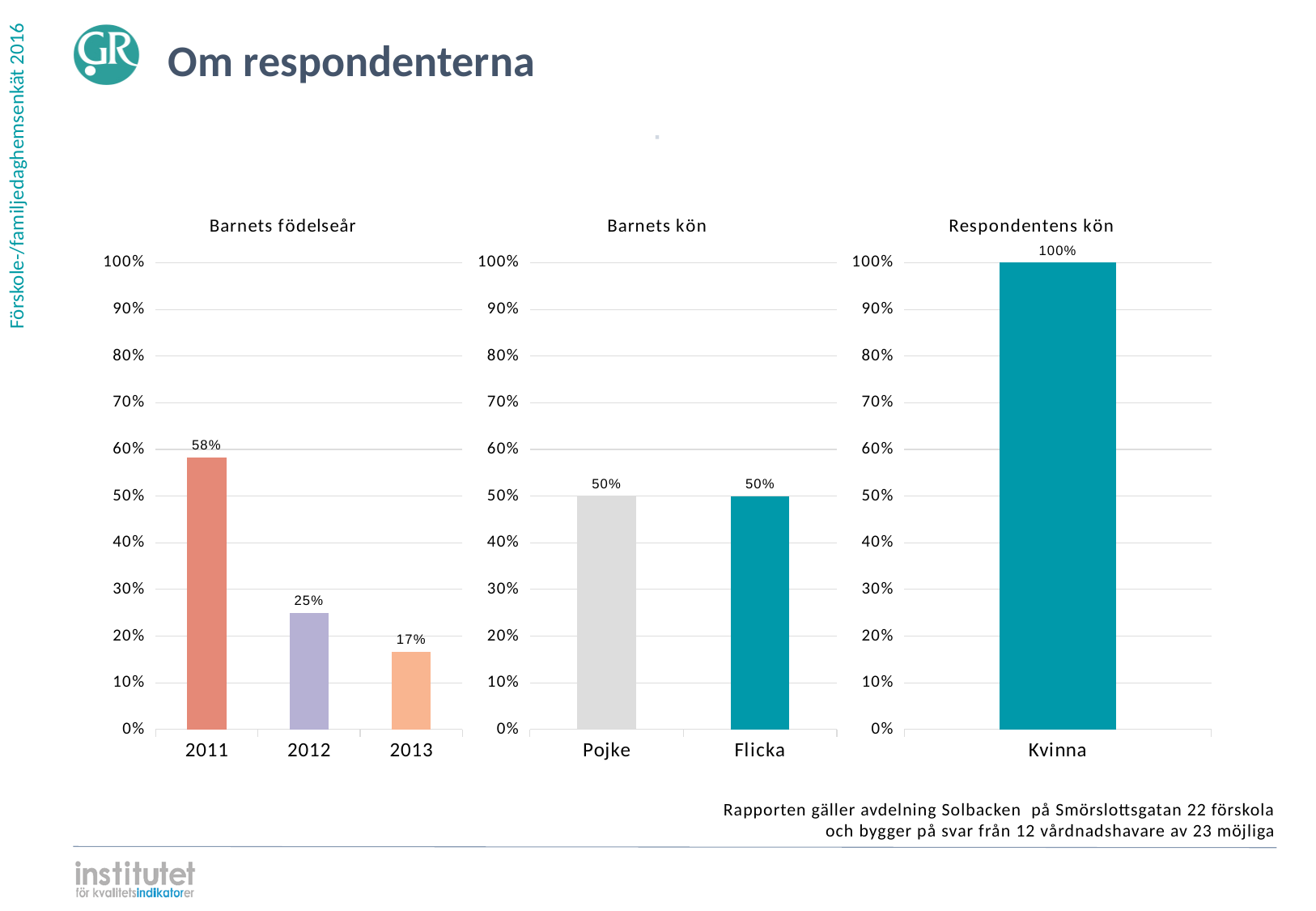
In the 'Respondentens kön' chart, what is the value for Kvinna? 100% In the 'Respondentens kön' chart, how many categories are shown? 1 What kind of chart is the 'Barnets kön' chart? bar chart In the 'Barnets födelseår' chart, which birth year has the lowest value? 2013 In the 'Barnets födelseår' chart, do the values rise or fall from 2011 to 2013? fall In the 'Barnets födelseår' chart, which birth year has the highest value? 2011 In the 'Barnets födelseår' chart, how many birth years are shown? 3 In the 'Barnets kön' chart, what is the value for Flicka? 50% In the 'Barnets kön' chart, what is the value for Pojke? 50% In the 'Barnets födelseår' chart, what is the difference between the values for 2011 and 2012? 33% In the 'Barnets födelseår' chart, what is the value for 2013? 17% In the 'Barnets födelseår' chart, what is the value for 2011? 58%